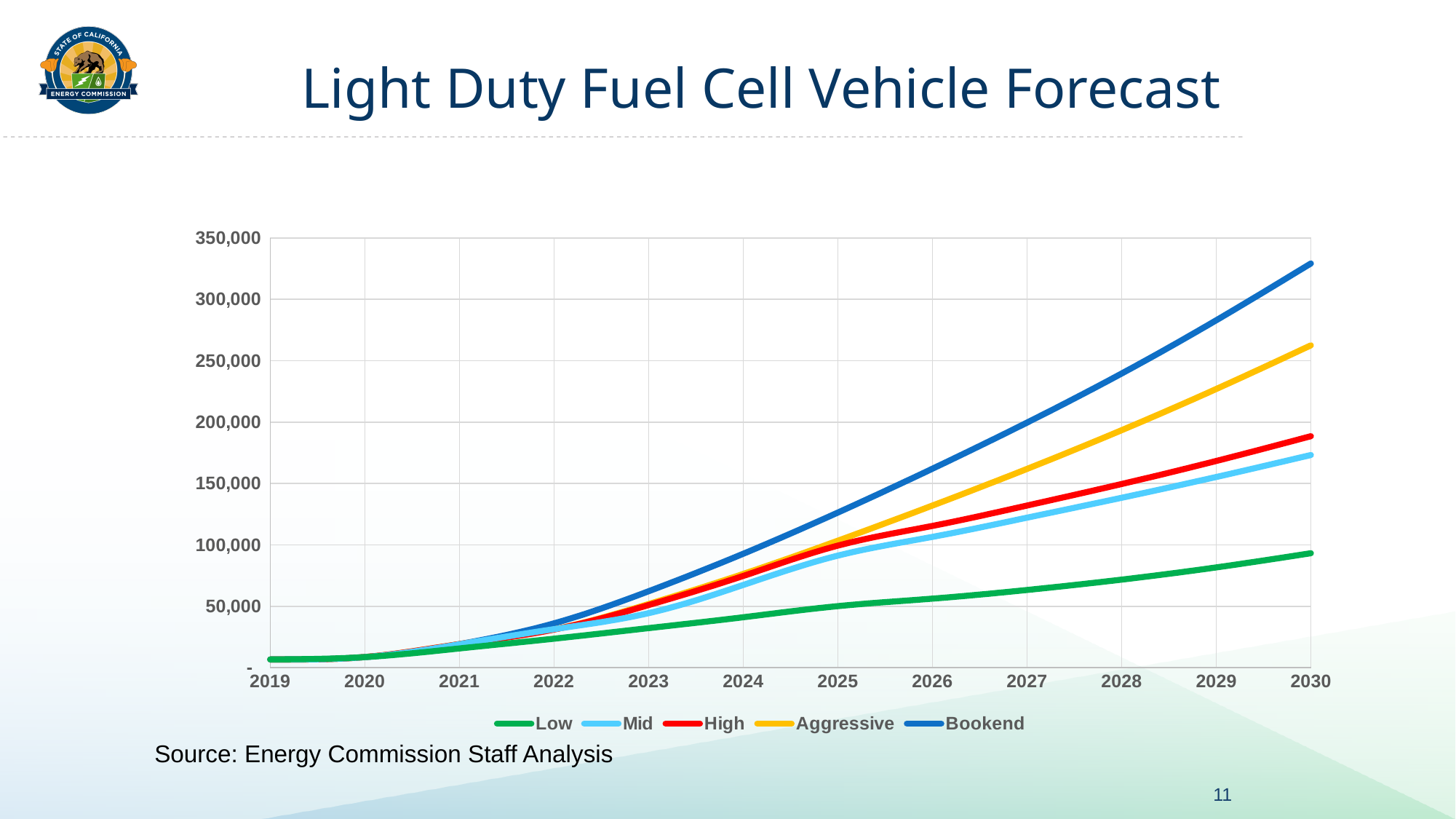
Which series has the lowest value in 2030? Low How many years are shown along the x axis? 12 Is the value for Low in 2030 greater or less than 100,000? less Do the values of the Bookend series rise or fall from 2019 to 2030? rise Is the value for High in 2030 greater or less than 200,000? less Is the value for Bookend in 2030 greater or less than 300,000? greater What is the title of the chart on the slide? Light Duty Fuel Cell Vehicle Forecast Which series has the highest value in 2030? Bookend What kind of chart is shown on the slide? line chart How many series does the legend list? 5 In 2030, which is larger, the Aggressive series or the High series? Aggressive